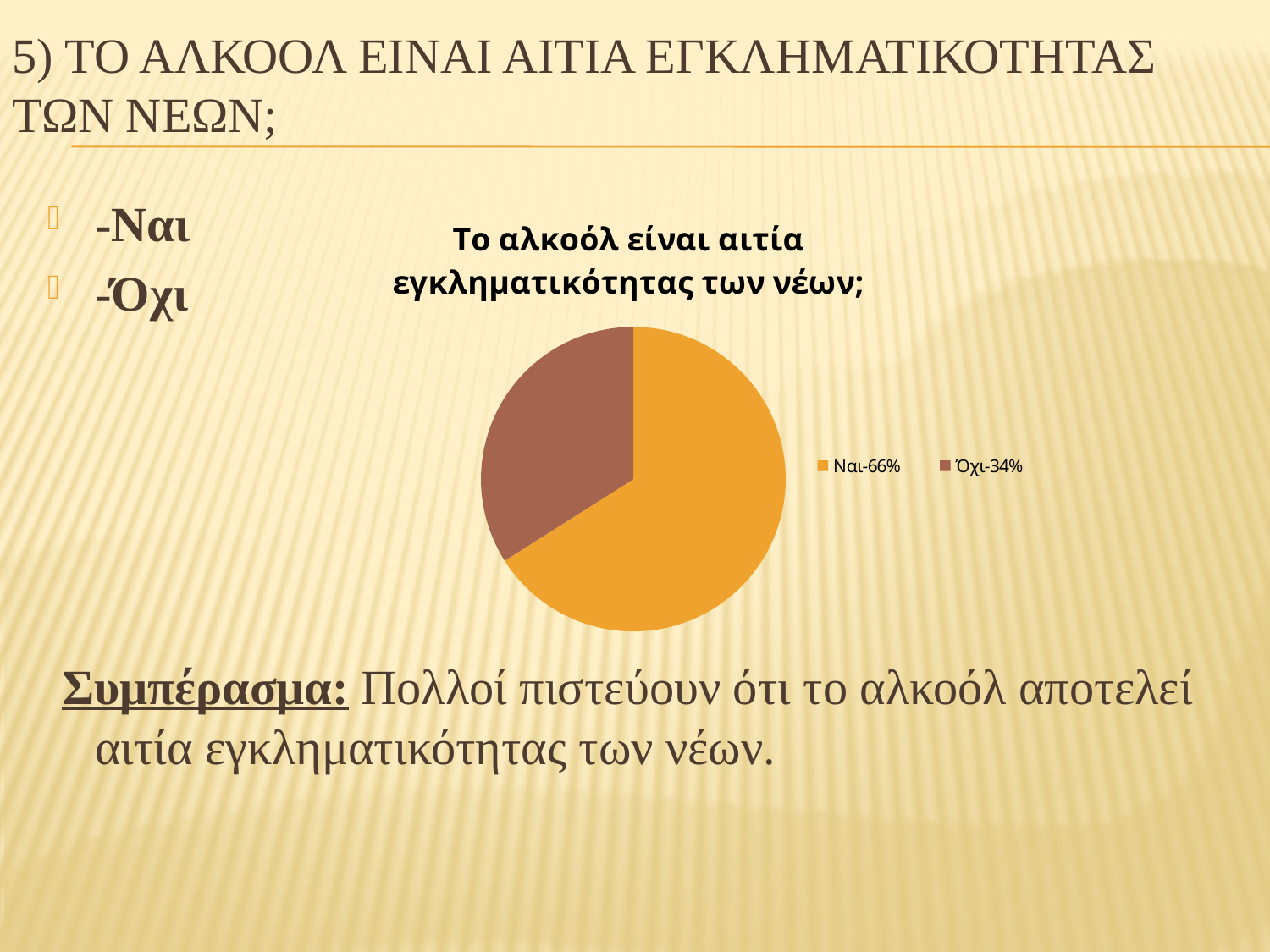
Which is larger, the 'Ναι' slice or the 'Όχι' slice? Ναι What colour is the 'Όχι' slice? brown What is the title of the chart? Το αλκοόλ είναι αιτία εγκληματικότητας των νέων; Which slice is the largest? Ναι How many entries does the legend list? 2 Is the share for 'Ναι' greater or less than 50%? greater Which slice is the smallest? Όχι What kind of chart is shown on the slide? pie chart What is the difference in percentage points between the 'Ναι' and 'Όχι' slices? 32 How many slices does the pie chart have? 2 What share of the pie does 'Όχι' represent? 34% What share of the pie does 'Ναι' represent? 66%